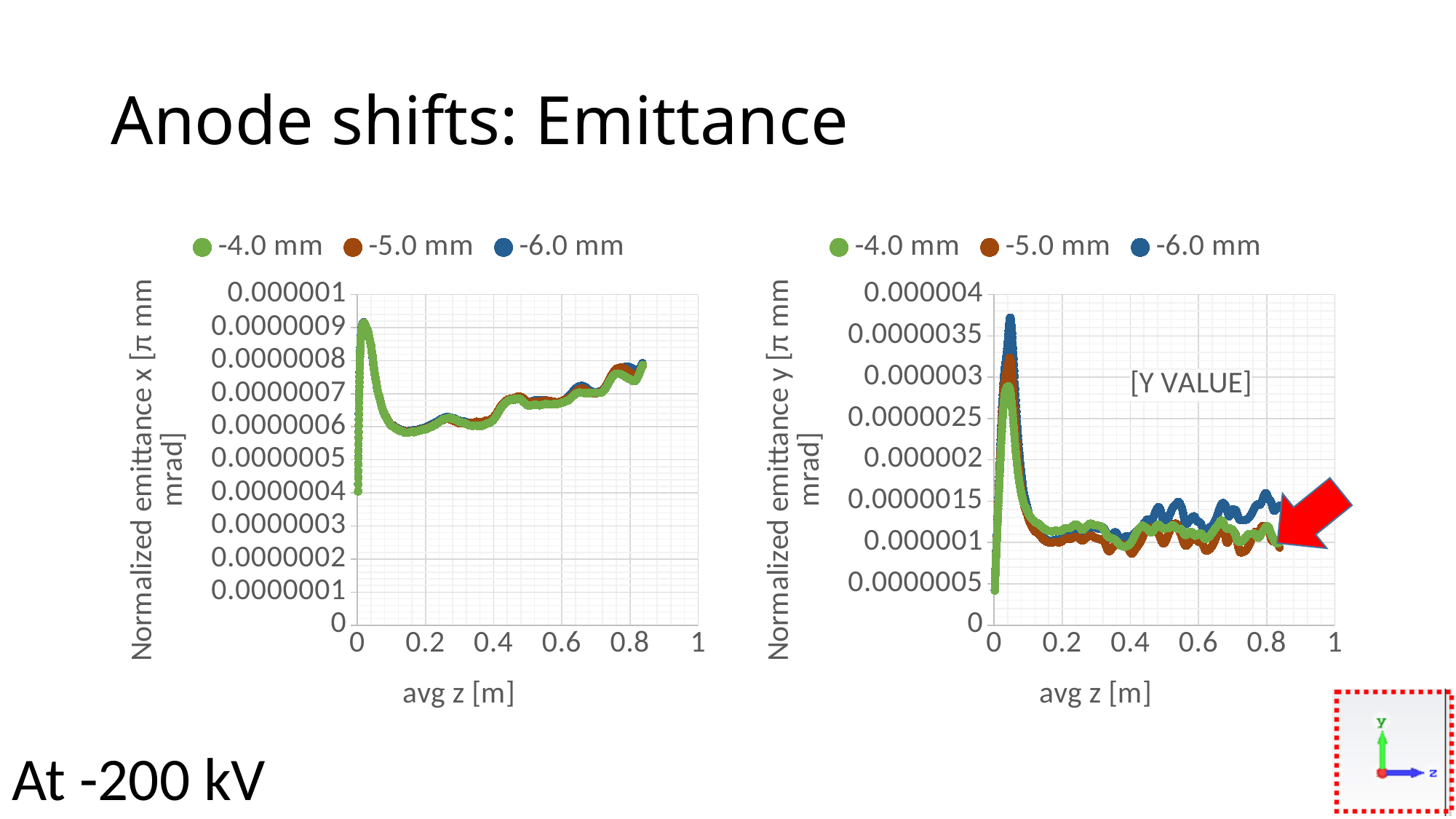
What is the x-axis label of the right chart (Normalized emittance y)? avg z [m] How many series does the legend of the left chart (Normalized emittance x) list? 3 In the right chart (Normalized emittance y), at avg z = 0.8, which series has the larger value: -6.0 mm or -5.0 mm? -6.0 mm In the right chart (Normalized emittance y), is the value of the -6.0 mm series at avg z = 0.4 greater or less than 0.000002? less How many series does the legend of the right chart (Normalized emittance y) list? 3 In the right chart (Normalized emittance y), is the peak value of the -6.0 mm series greater or less than 0.0000035? greater What are the legend entries of the left chart (Normalized emittance x)? -4.0 mm, -5.0 mm, -6.0 mm In the right chart (Normalized emittance y), is the peak value of the -4.0 mm series greater or less than 0.0000035? less In the left chart (Normalized emittance x), do the values generally rise or fall between avg z = 0.2 and avg z = 0.8? rise In the right chart (Normalized emittance y), which series reaches the highest peak value? -6.0 mm